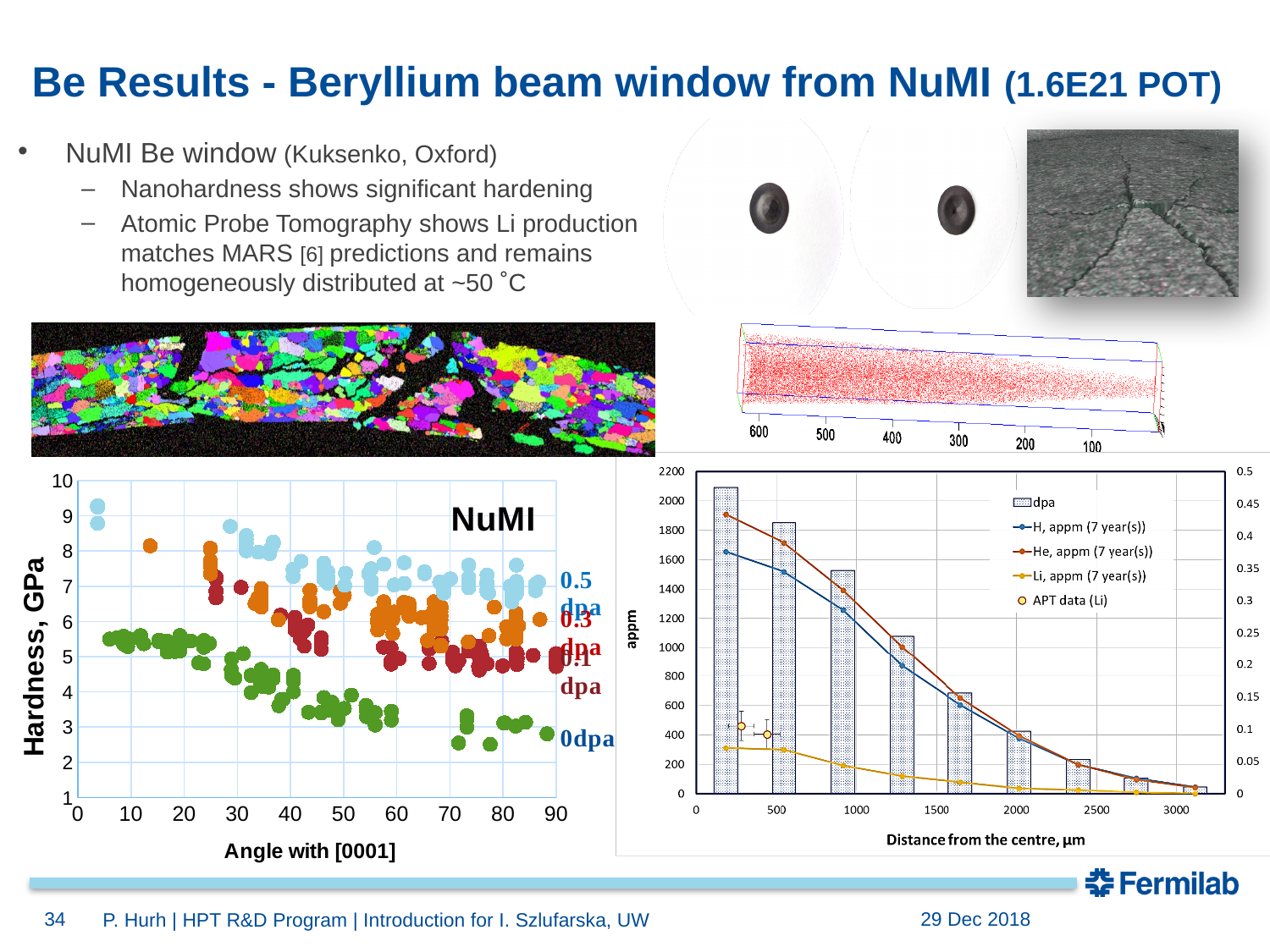
In the left NuMI chart, how many dpa series are plotted? 4 In the left NuMI chart, what is the y-axis title? Hardness, GPa In the left NuMI chart, which series shows the highest hardness values? 0.5 dpa In the left NuMI chart, which series shows the lowest hardness values? 0dpa In the right chart, how many entries does the legend list? 5 In the left NuMI chart, what is the x-axis title? Angle with [0001] In the right chart, do the dpa bars rise or fall as the distance from the centre increases? fall What kind of chart is the left chart titled NuMI? scatter chart In the right chart, at a distance of about 500 µm, which is larger: H appm or He appm? He, appm (7 year(s)) In the left NuMI chart, does the hardness of the 0dpa series rise or fall as the angle increases? fall In the right chart, how many dpa bars are plotted? 9